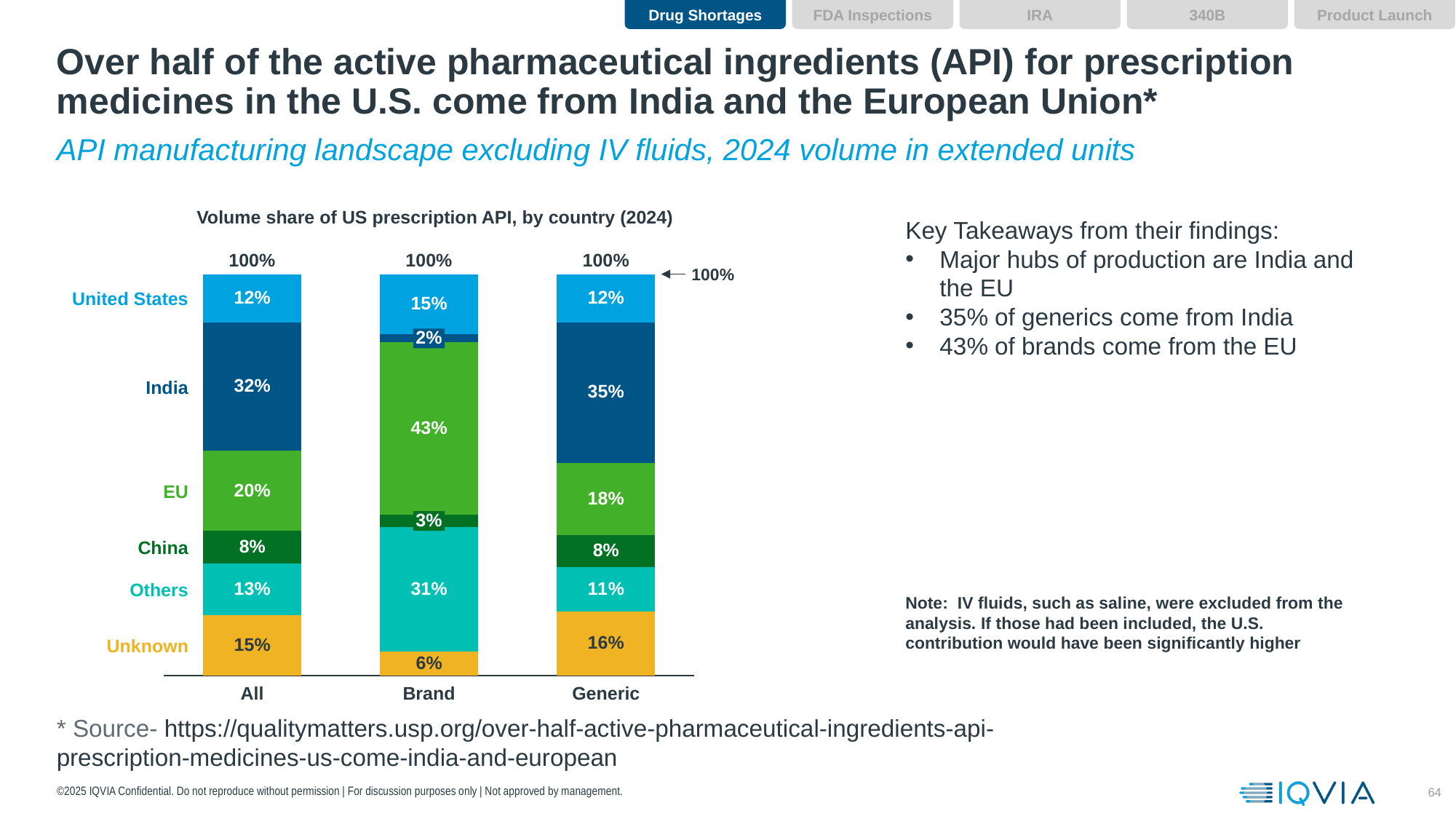
What is the Unknown share of the All bar? 15% What is the India share of the Brand bar? 2% What is the Others share of the Brand bar? 31% How many country series are stacked in each bar? 6 What is the EU share of the Generic bar? 18% What type of chart is shown? Stacked bar chart Which country segment is the smallest in the Generic bar? China Which country segment is the largest in the Brand bar? EU What is the title of the chart? Volume share of US prescription API, by country (2024) What is the difference between the India share in the Generic bar and the India share in the All bar? 3% How many bars (categories) are shown on the x axis? 3 Which is larger: the United States share in the Brand bar or the United States share in the Generic bar? Brand